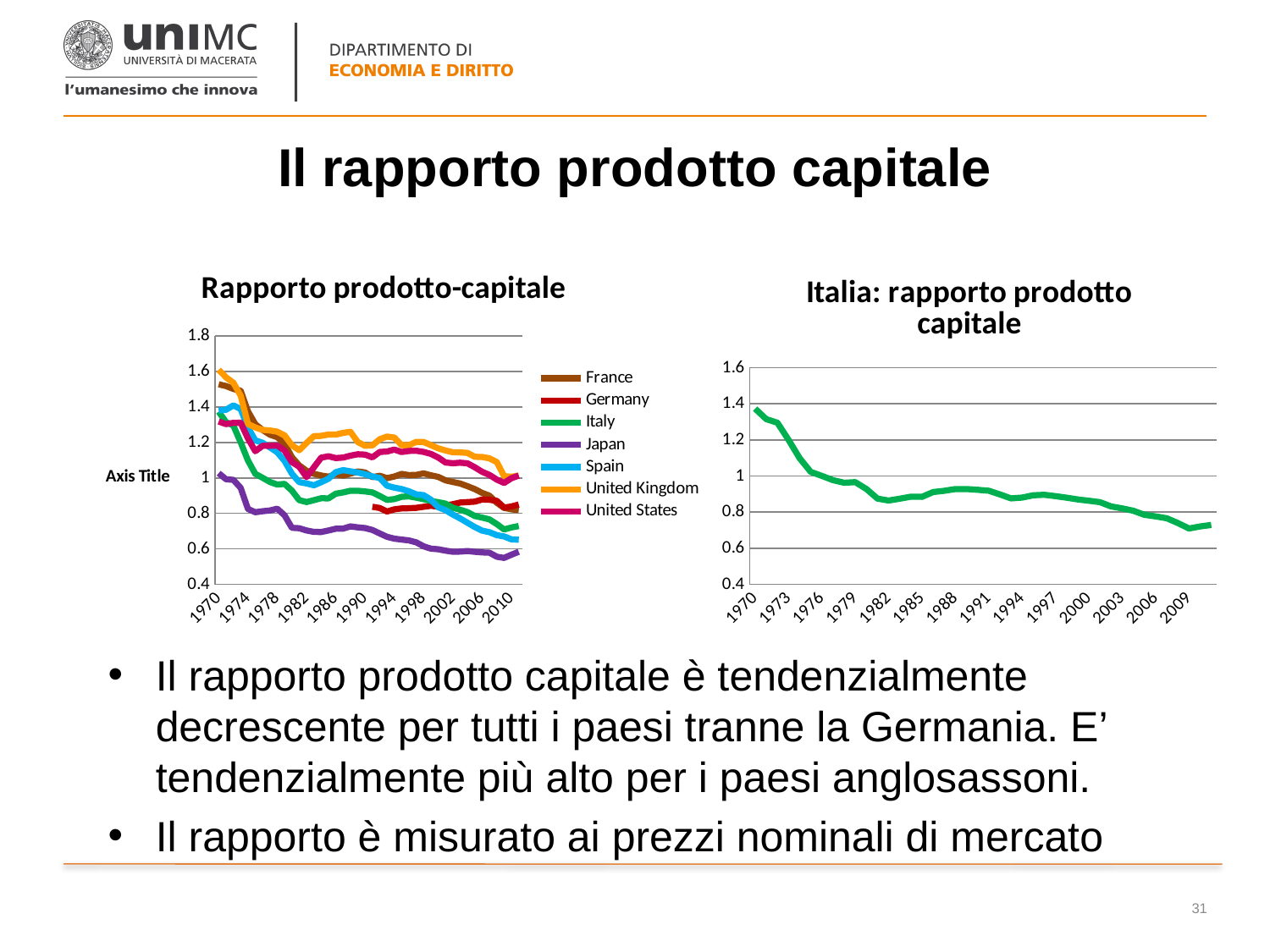
In the right chart "Italia: rapporto prodotto capitale", does the series rise or fall overall from 1970 to 2009? fall In the left chart "Rapporto prodotto-capitale", is the value for Japan in 1990 greater or less than 0.8? less What kind of chart is the left chart titled "Rapporto prodotto-capitale"? line chart What is the title of the right chart on the slide? Italia: rapporto prodotto capitale In the right chart "Italia: rapporto prodotto capitale", is the value for 2009 greater or less than 0.8? less How many series does the legend of the left chart "Rapporto prodotto-capitale" list? 7 In the left chart "Rapporto prodotto-capitale", which is larger in 1990, the value for United Kingdom or the value for Japan? United Kingdom In the left chart "Rapporto prodotto-capitale", does the Japan series rise or fall overall from 1970 to 2010? fall In the left chart "Rapporto prodotto-capitale", which series has the lowest value in 2010? Japan In the left chart "Rapporto prodotto-capitale", which series has the highest value in 1970? United Kingdom In the right chart "Italia: rapporto prodotto capitale", is the value for 1970 greater or less than 1.2? greater In the left chart "Rapporto prodotto-capitale", which series has the lowest value in 1970? Japan